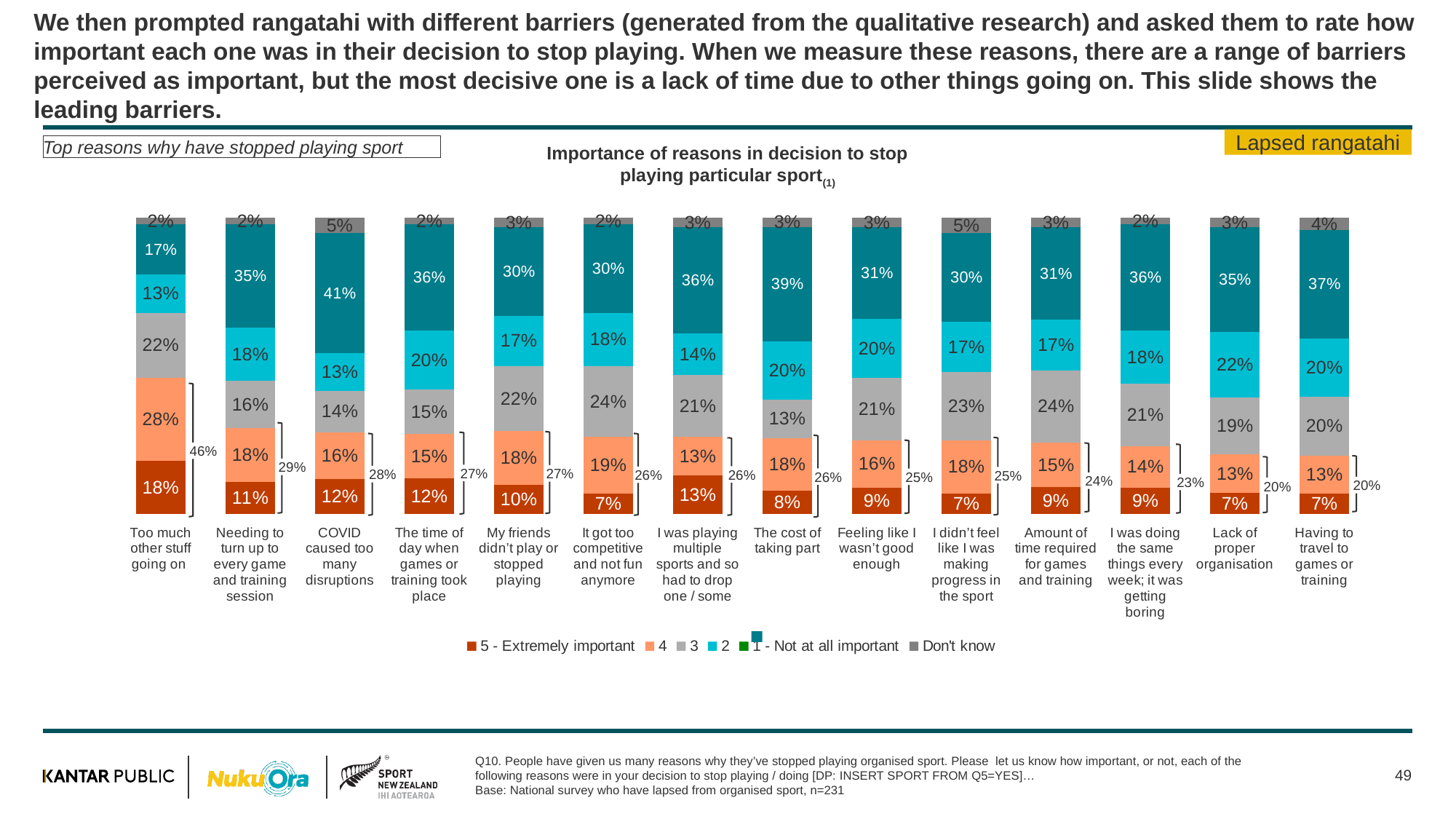
What percentage rated 'COVID caused too many disruptions' as 1 - Not at all important? 41% What kind of chart is shown on the slide? Stacked bar chart Which reason has the highest percentage rating it 5 - Extremely important? Too much other stuff going on What is the difference between the '4' rating for 'Too much other stuff going on' (28%) and for 'Lack of proper organisation' (13%)? 15% Which reason has the lowest percentage rating it 1 - Not at all important? Too much other stuff going on How many reasons (categories) are plotted in the chart? 14 What is the combined percentage (5 and 4 ratings) shown by the bracket for 'Too much other stuff going on'? 46% Which has a larger '1 - Not at all important' share: 'The cost of taking part' or 'My friends didn't play or stopped playing'? The cost of taking part What is the 'Don't know' percentage for 'I didn't feel like I was making progress in the sport'? 5% What percentage rated 'Too much other stuff going on' as 5 - Extremely important? 18% What is the title of the chart? Importance of reasons in decision to stop playing particular sport How many series does the legend list? 6